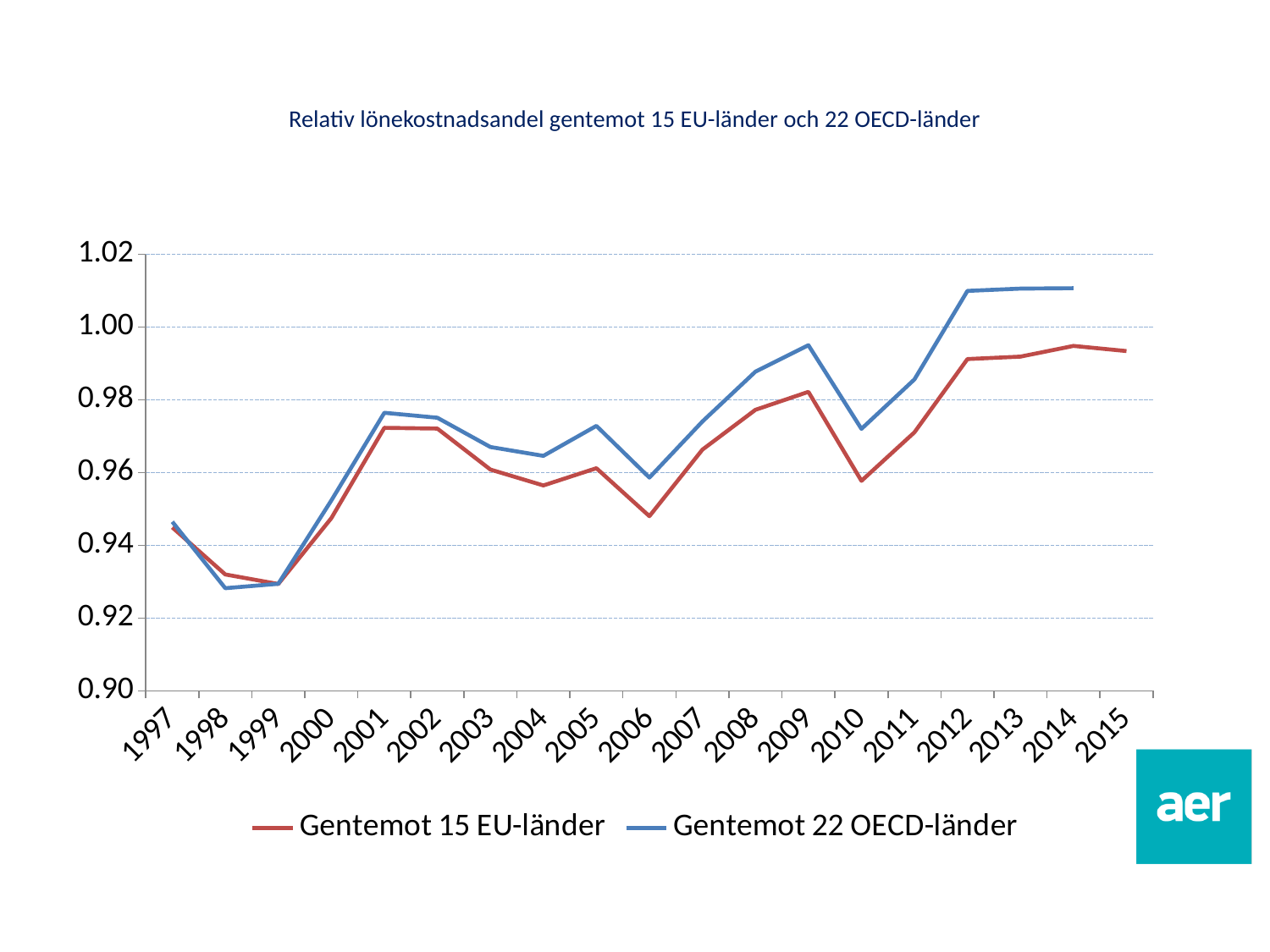
What kind of chart is shown on the slide? line chart Is the value for Gentemot 15 EU-länder in 2006 greater or less than 0.96? less How many series does the legend list? 2 How many years are shown on the x axis? 19 Is the value for Gentemot 22 OECD-länder in 2009 greater or less than 1.00? less Is the value for Gentemot 22 OECD-länder in 2012 greater or less than 1.00? greater Which series is drawn in blue? Gentemot 22 OECD-länder For Gentemot 15 EU-länder, which year has the higher value, 2009 or 2010? 2009 What is the title of the chart? Relativ lönekostnadsandel gentemot 15 EU-länder och 22 OECD-länder Do the values for Gentemot 15 EU-länder rise or fall from 2010 to 2012? rise In 2012, which series has the higher value, Gentemot 15 EU-länder or Gentemot 22 OECD-länder? Gentemot 22 OECD-länder